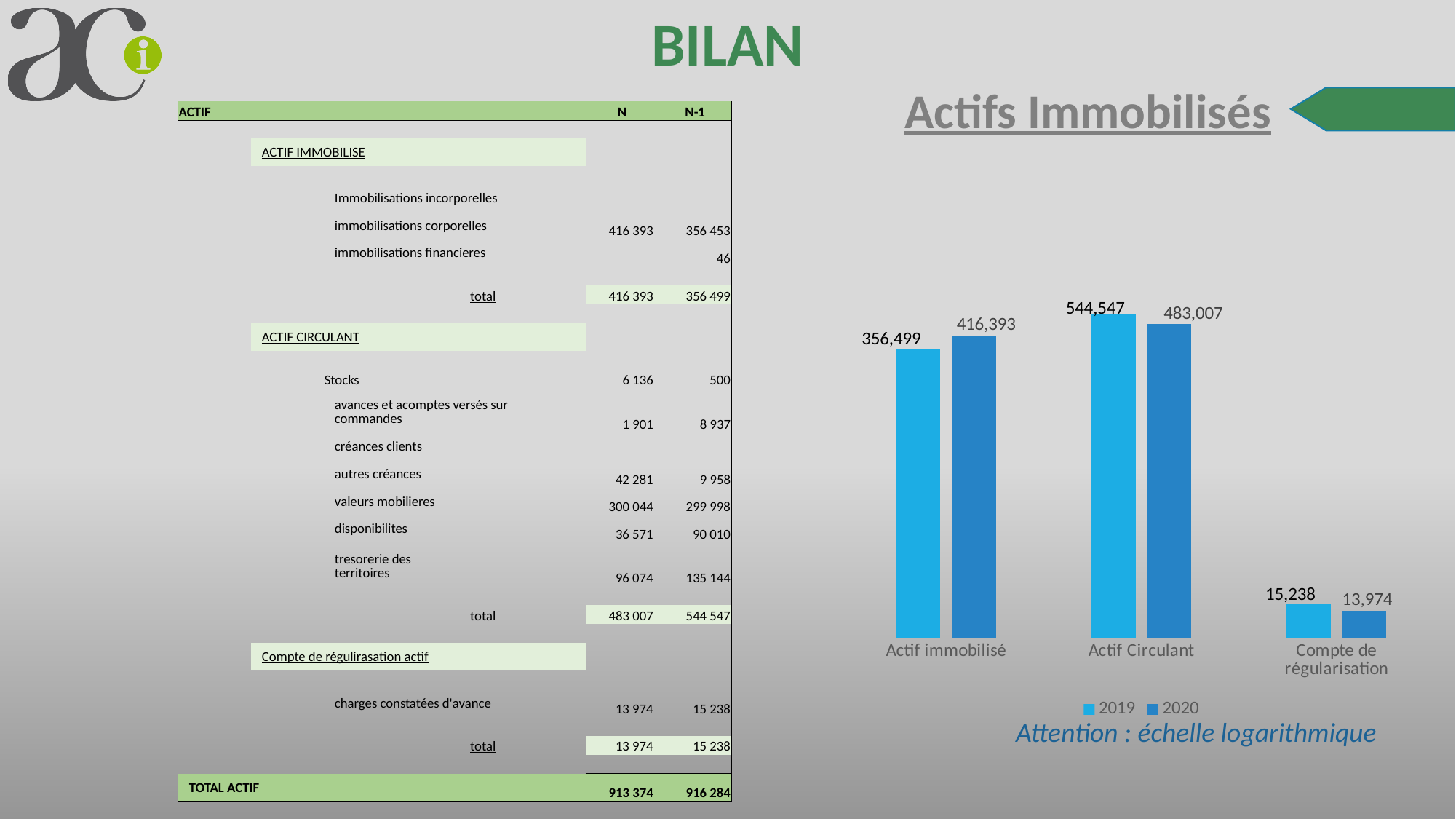
Which category has the highest value in the 2020 series? Actif Circulant Which category has the lowest value in the 2019 series? Compte de régularisation What is the value for Actif immobilisé in 2020? 416,393 What is the difference between the 2019 and 2020 values for Actif Circulant? 61,540 What type of chart is shown on the slide? Bar chart What is the value for Compte de régularisation in 2020? 13,974 What is the difference between the 2020 and 2019 values for Actif immobilisé? 59,894 For Actif Circulant, which year has the larger value, 2019 or 2020? 2019 How many categories are shown on the x axis of the chart? 3 What is the value for Actif immobilisé in 2019? 356,499 How many series does the chart legend list? 2 What is the value for Actif Circulant in 2019? 544,547